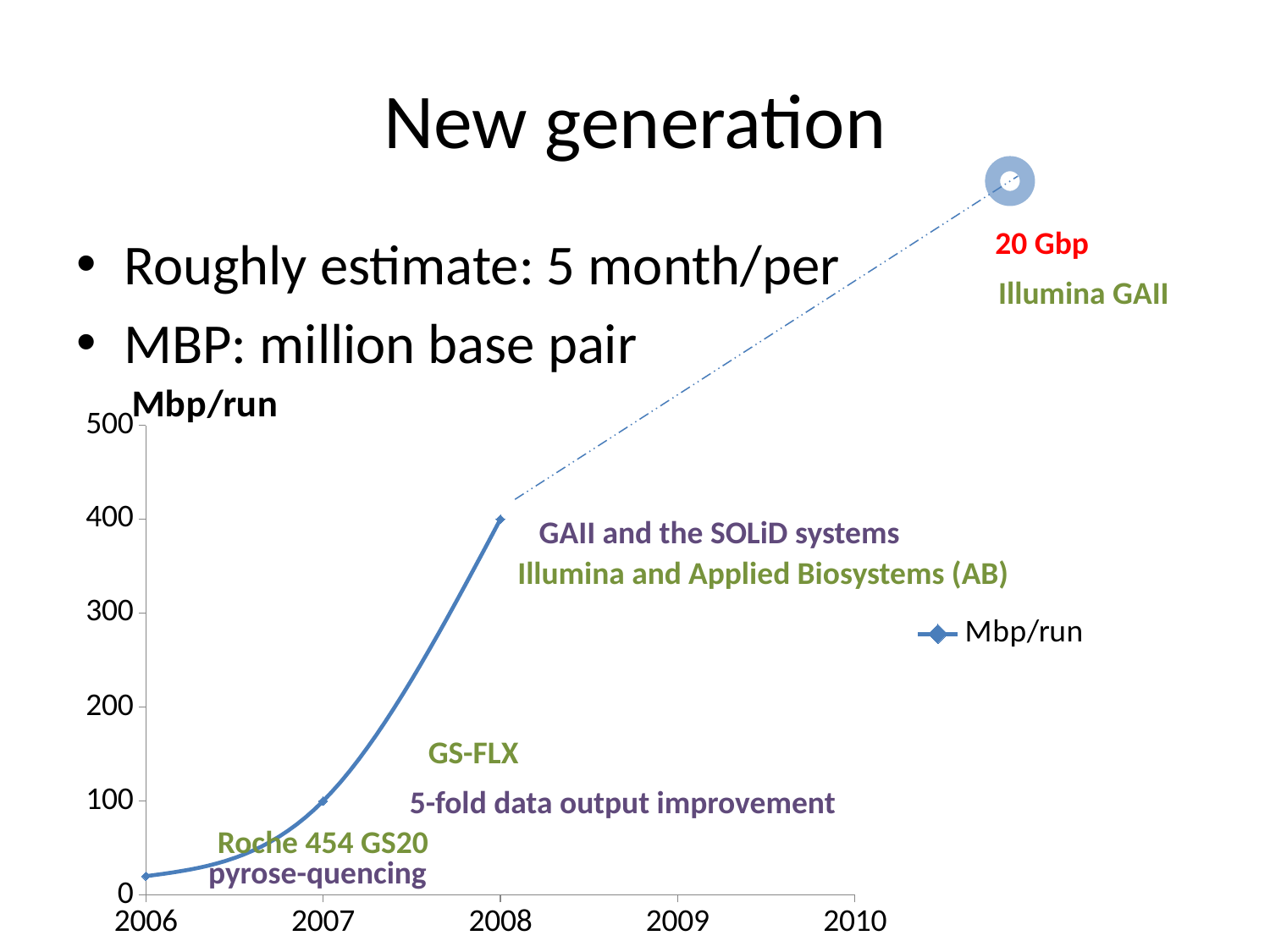
What kind of chart is shown on the slide? line chart Which year has the highest plotted Mbp/run value? 2008 What is the name of the series shown in the legend? Mbp/run What is the Mbp/run value plotted for 2007? 100 What is the Mbp/run value plotted for 2008? 400 What is the difference between the Mbp/run values for 2008 and 2007? 300 Do the Mbp/run values rise or fall from 2006 to 2008? rise Which is larger, the Mbp/run value for 2007 or for 2008? 2008 How many series does the legend list? 1 How many data points are plotted on the Mbp/run line? 3 Is the Mbp/run value for 2006 greater or less than 100? less Which year has the lowest plotted Mbp/run value? 2006